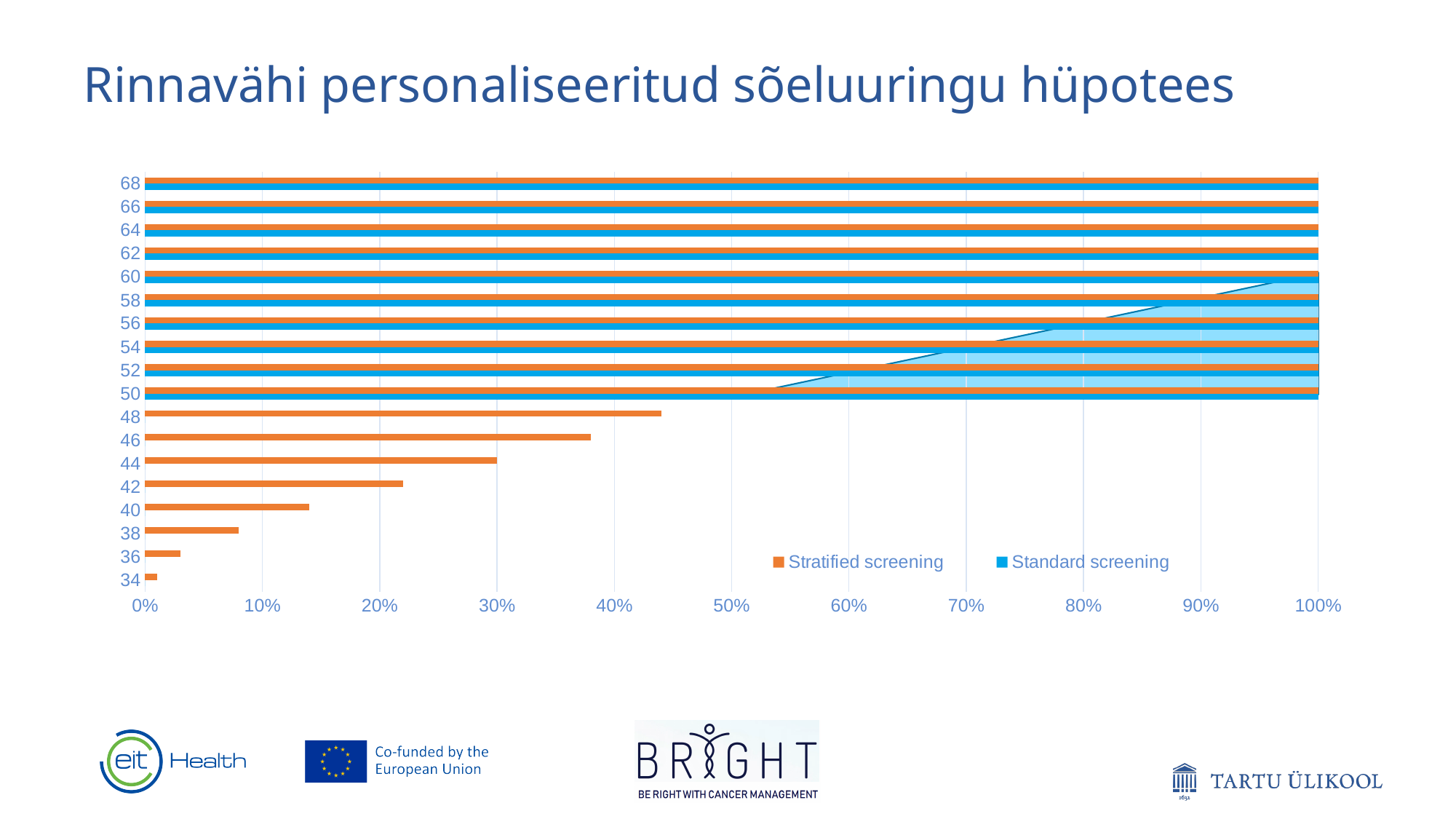
Which age category has the lowest Stratified screening value? 34 Is the Stratified screening value for age 46 greater or less than 30%? greater How many series does the legend list? 2 What are the two series named in the legend? Stratified screening and Standard screening Is the Stratified screening value for age 48 greater or less than 40%? greater Do the Stratified screening values rise or fall as age increases from 34 to 50? rise Is the Stratified screening value for age 36 greater or less than 10%? less How many age categories are shown on the vertical axis? 18 What kind of chart is shown on the slide? bar chart What colour represents the Standard screening series? blue Which has the larger Stratified screening value, age 42 or age 48? age 48